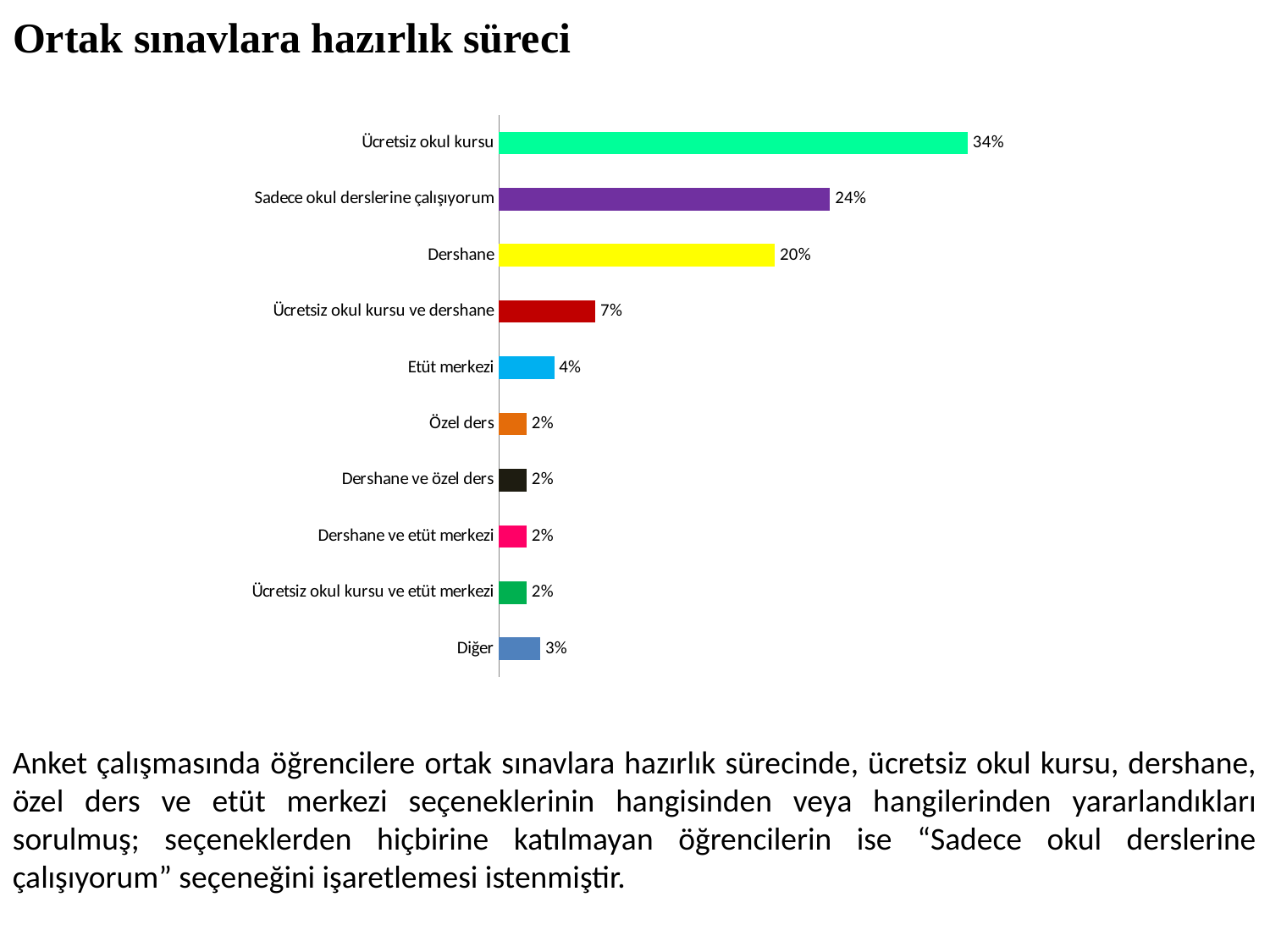
What percentage is shown for "Diğer"? 3% What percentage is shown for "Dershane"? 20% How many categories are shown in the chart? 10 What is the difference between the percentages for "Ücretsiz okul kursu" and "Sadece okul derslerine çalışıyorum"? 10% Which is larger, the percentage for "Etüt merkezi" or for "Diğer"? Etüt merkezi What kind of chart is shown on the slide? Bar chart Which category has the highest percentage? Ücretsiz okul kursu What percentage is shown for "Ücretsiz okul kursu"? 34% What is the title of the slide containing the chart? Ortak sınavlara hazırlık süreci What is the difference between the percentages for "Dershane" and "Ücretsiz okul kursu ve dershane"? 13% What percentage is shown for "Etüt merkezi"? 4% Which is larger, the percentage for "Sadece okul derslerine çalışıyorum" or for "Dershane"? Sadece okul derslerine çalışıyorum